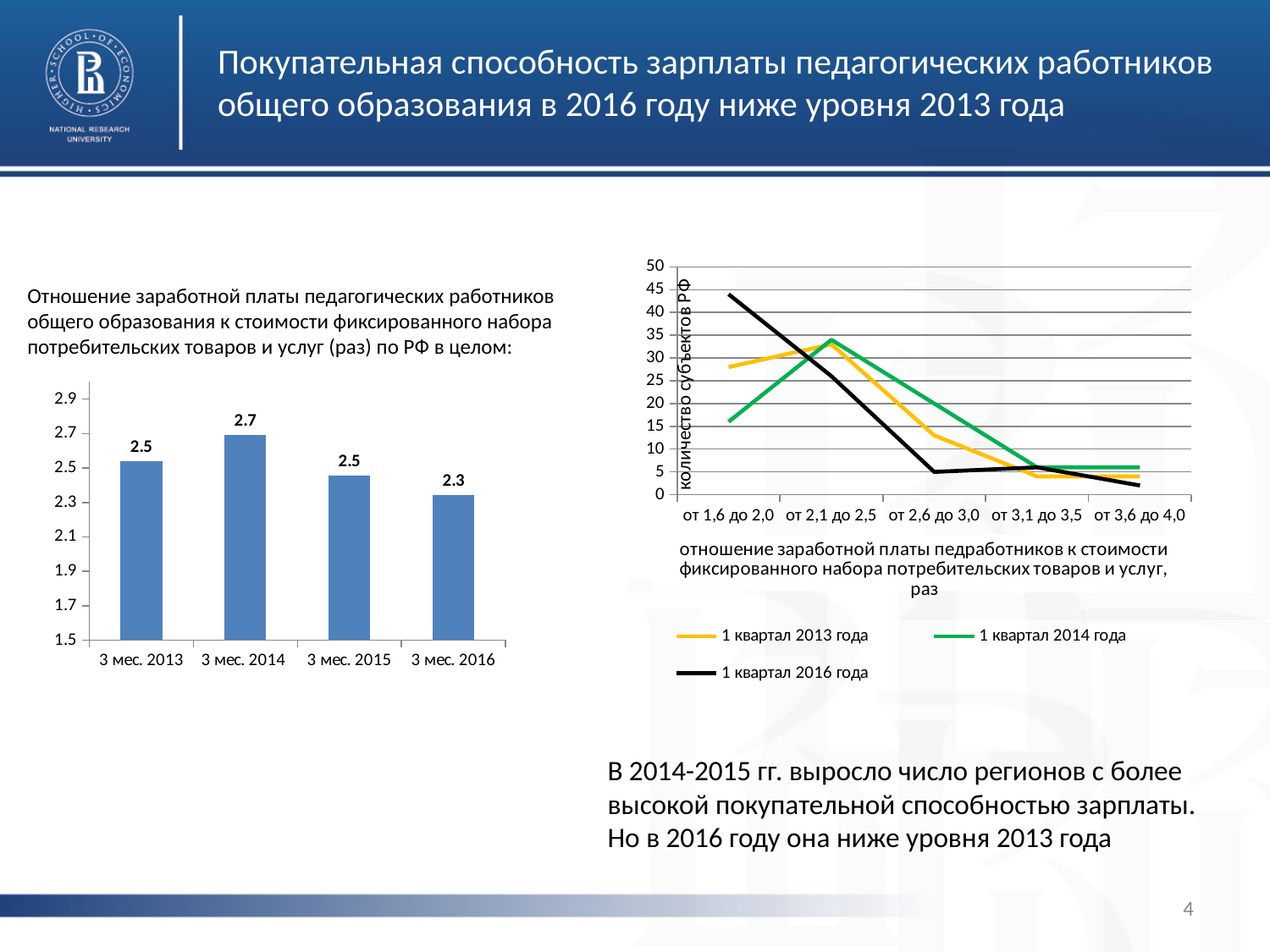
What kind of chart is the chart on the right side of the slide? line chart On the right line chart, is the value of the 1 квартал 2016 года series for от 2,6 до 3,0 greater or less than 10? less On the left bar chart, what is the value for 3 мес. 2016? 2.3 On the right line chart, is the value of the 1 квартал 2016 года series for от 1,6 до 2,0 greater or less than 40? greater On the left bar chart, which period has the lowest value? 3 мес. 2016 On the right line chart, how many series does the legend list? 3 On the left bar chart, how many periods are shown on the x axis? 4 On the left bar chart, which period has the highest value? 3 мес. 2014 On the left bar chart, what is the difference between the values for 3 мес. 2014 and 3 мес. 2016? 0.4 On the left bar chart, do the values rise or fall from 3 мес. 2014 to 3 мес. 2016? fall On the right line chart, at от 1,6 до 2,0, which series has the larger value: 1 квартал 2016 года or 1 квартал 2014 года? 1 квартал 2016 года On the left bar chart, what is the value for 3 мес. 2014? 2.7